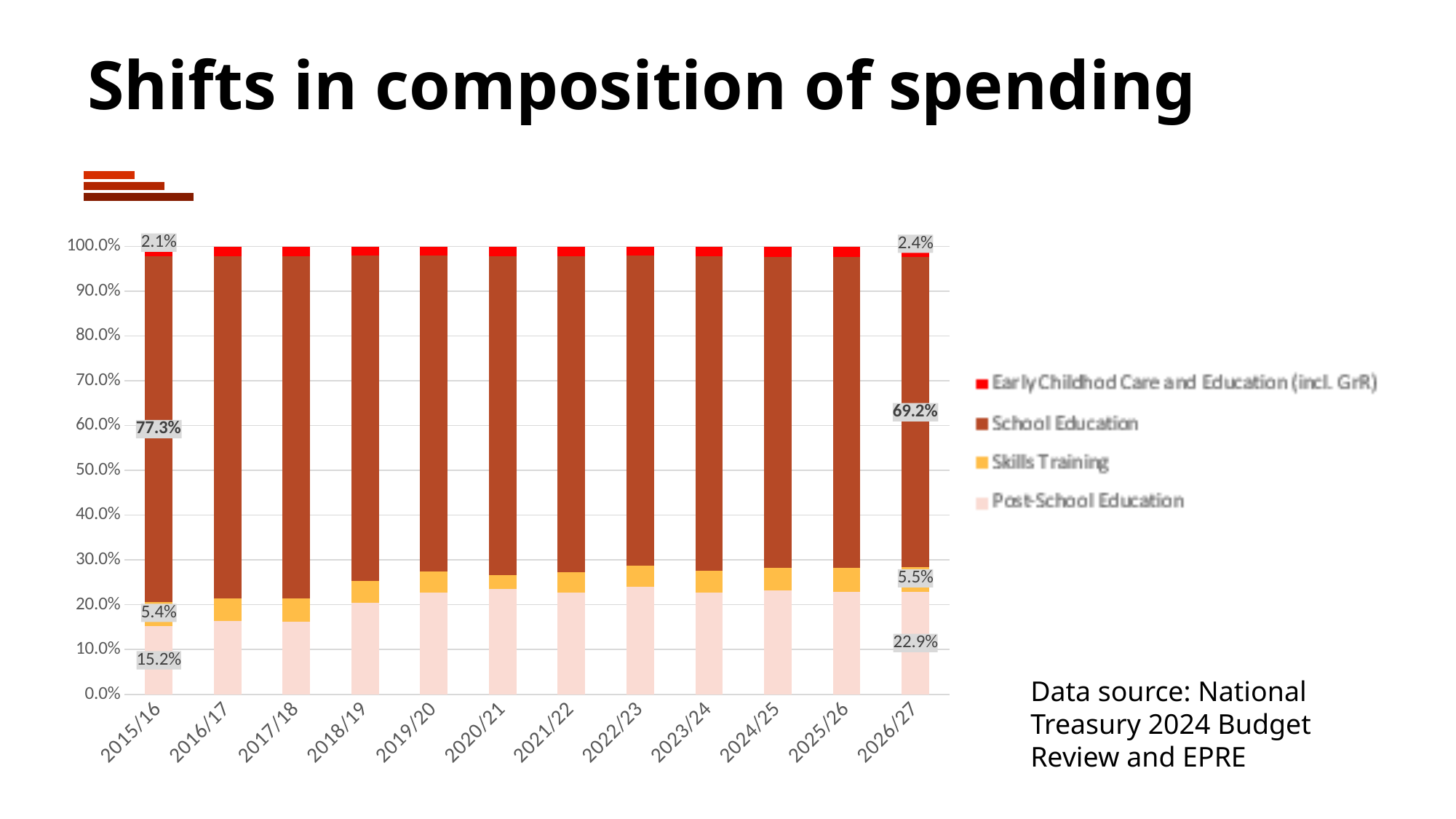
Which series has the smallest share in 2026/27? Early Childhood Care and Education (incl. GrR) What is the share of Skills Training in 2026/27? 5.5% How many financial years are shown on the x axis? 12 What kind of chart is shown on the slide? stacked bar chart Which is larger: the Post-School Education share in 2015/16 or in 2026/27? 2026/27 What is the share of School Education in 2015/16? 77.3% How many series does the legend list? 4 What is the share of Post-School Education in 2026/27? 22.9% Does the share of Post-School Education rise or fall from 2015/16 to 2026/27? rise By how many percentage points does the School Education share fall from 2015/16 to 2026/27? 8.1 percentage points What is the share of Early Childhood Care and Education (incl. GrR) in 2015/16? 2.1% What is the share of School Education in 2026/27? 69.2%